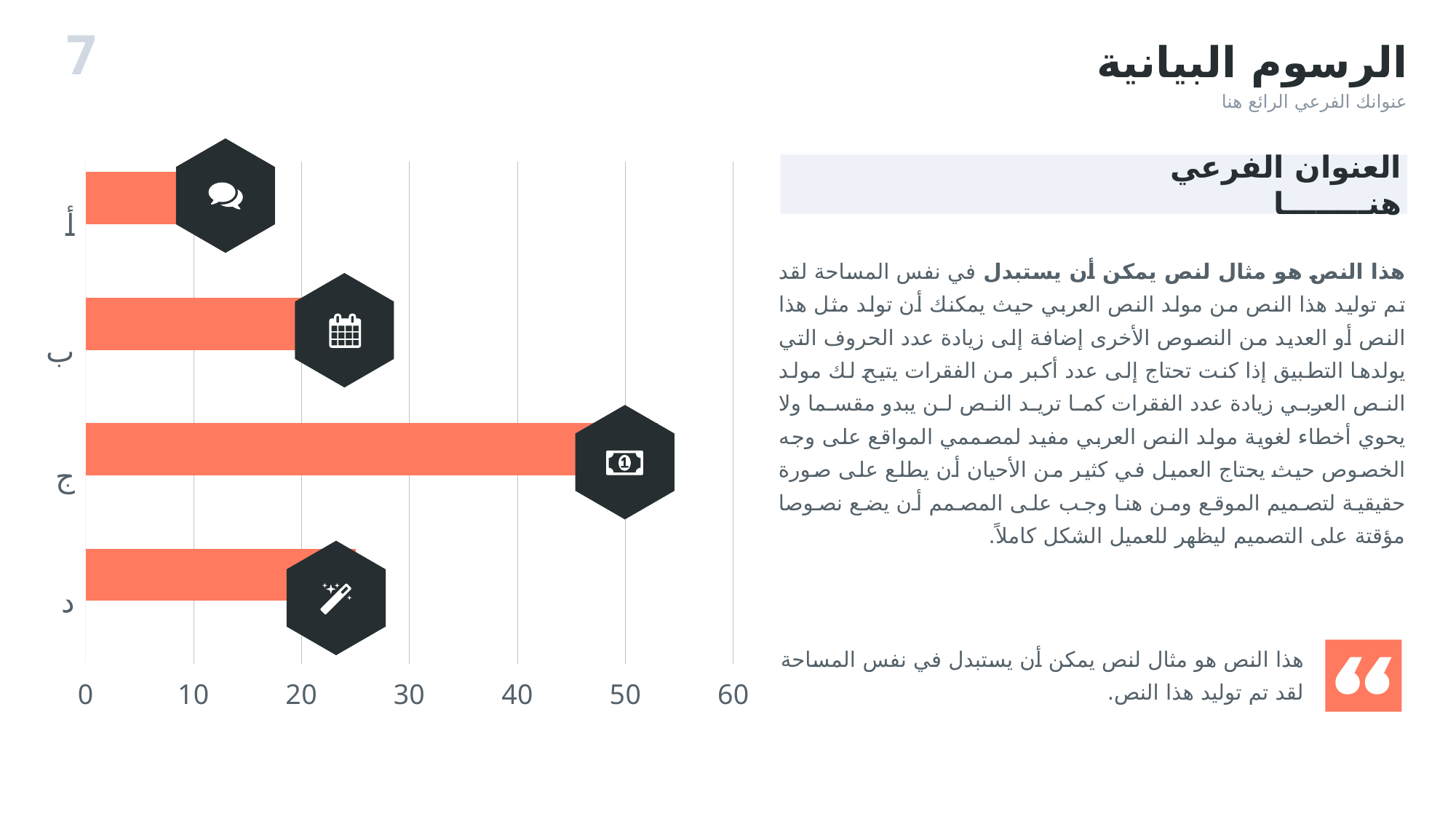
Is the value for أ greater or less than 20? less Is the value for ب greater or less than 30? less Which is larger, the value for أ or the value for ج? ج How many categories does the bar chart show? 4 What kind of chart is shown on the slide? bar chart Which is larger, the value for ج or the value for ب? ج Which category has the lowest value in the bar chart? أ Which category has the highest value in the bar chart? ج Is the value for د greater or less than 40? less What colour are the bars in the chart? orange What is the highest value shown on the chart's horizontal axis? 60